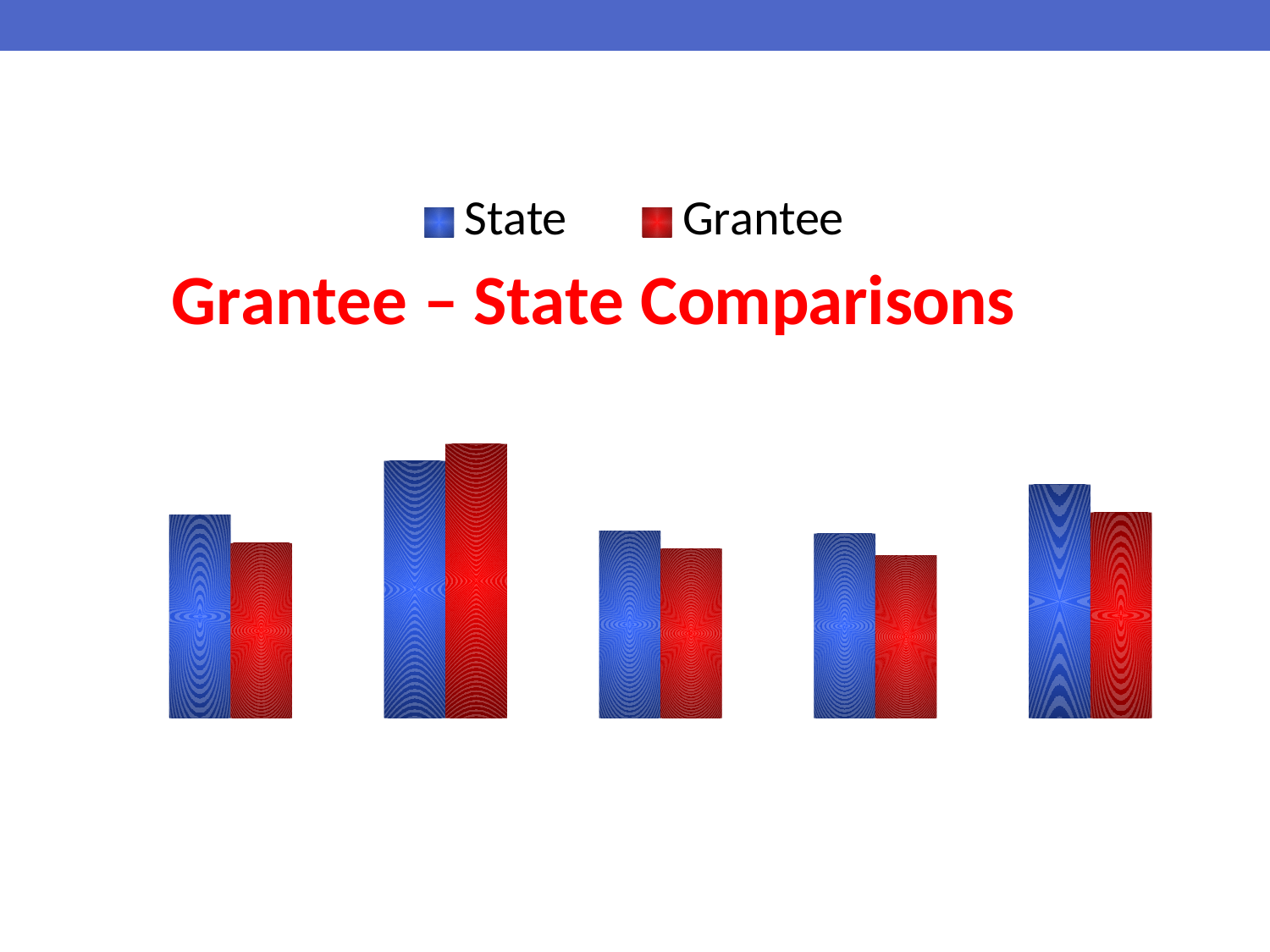
What is the title of the chart? Grantee – State Comparisons In how many of the groups is the Grantee bar taller than the State bar? 1 How many groups of bars are plotted in the chart? 5 In the second group of bars from the left, which is taller, State or Grantee? Grantee In the rightmost group of bars, which is taller, State or Grantee? State In the middle group of bars, which is taller, State or Grantee? State Which colour represents the Grantee series in the legend? Red Which group of bars has the tallest State bar? The second group from the left Which group of bars has the tallest Grantee bar? The second group from the left How many series does the legend list? 2 What kind of chart is shown on the slide? Bar chart